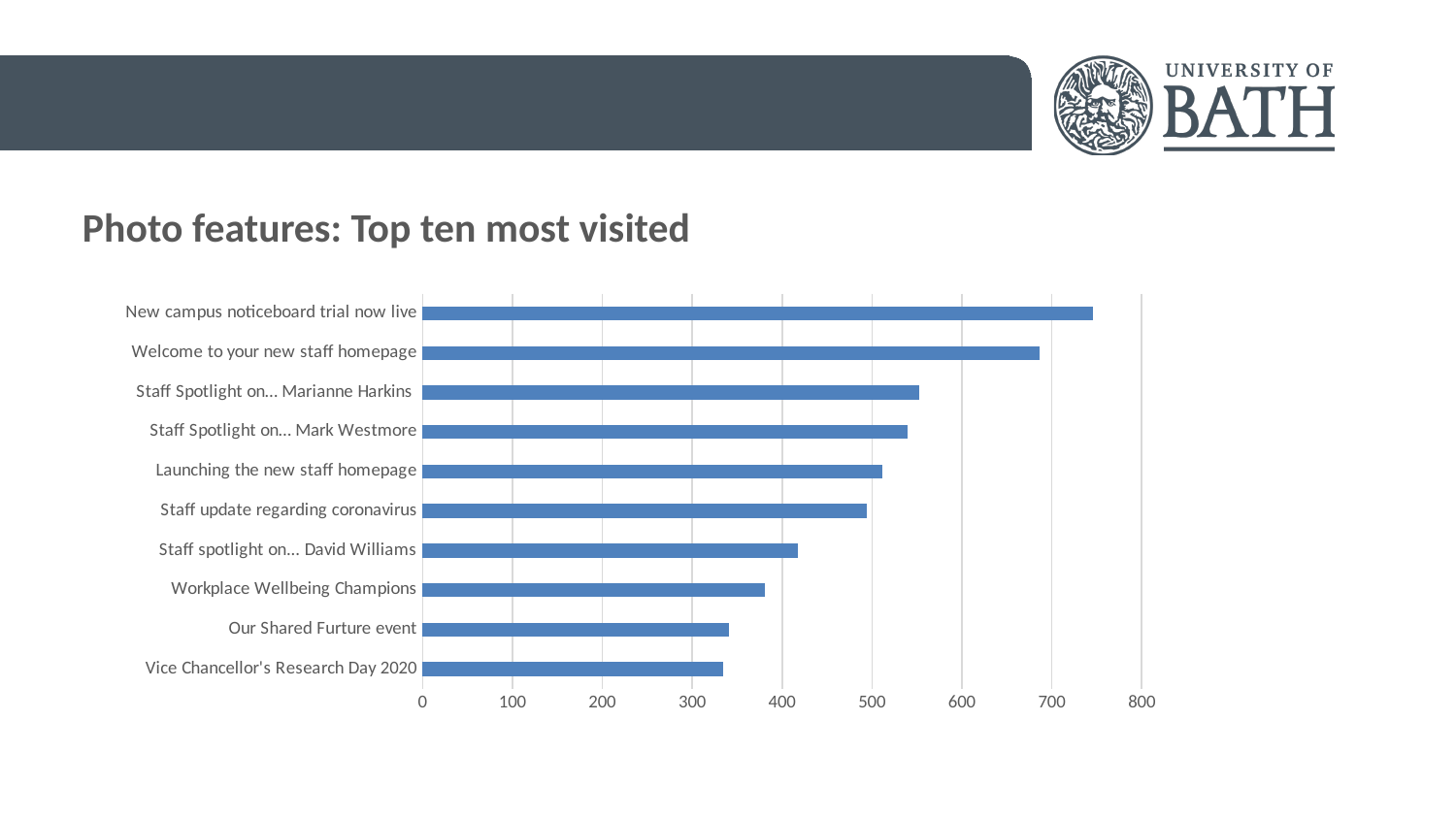
What kind of chart is shown on the slide? bar chart Which photo feature has the lowest number of visits? Vice Chancellor's Research Day 2020 How many photo features are listed in the chart? 10 Which has more visits: Welcome to your new staff homepage or Staff update regarding coronavirus? Welcome to your new staff homepage Is the value for Staff Spotlight on... Marianne Harkins greater or less than 500? greater Is the value for Staff spotlight on... David Williams greater or less than 500? less Which has more visits: Our Shared Furture event or Launching the new staff homepage? Launching the new staff homepage What is the title of the slide's chart? Photo features: Top ten most visited Is the value for Welcome to your new staff homepage greater or less than 600? greater Which photo feature has the highest number of visits? New campus noticeboard trial now live